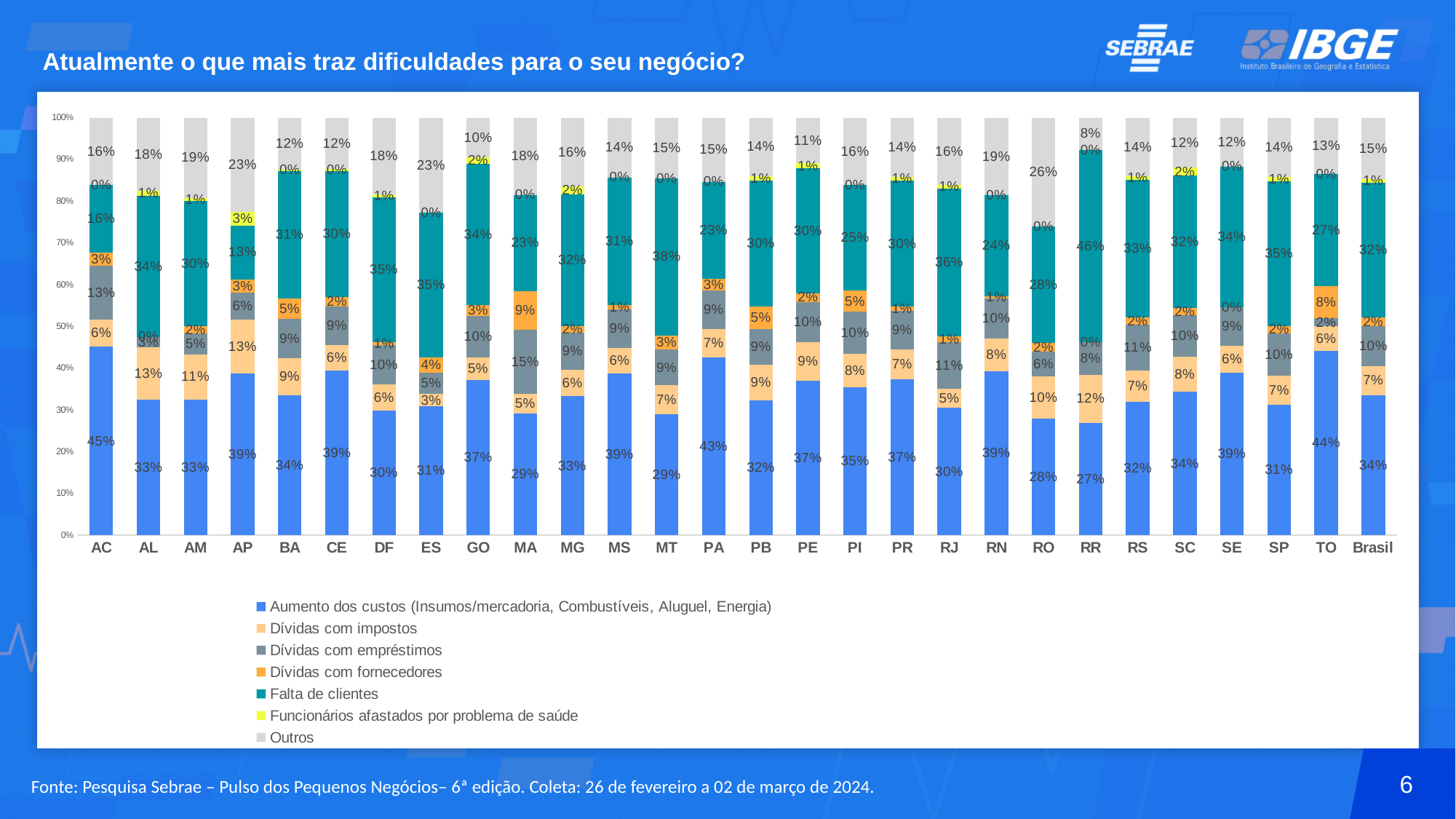
Which category has the highest value for 'Outros'? RO What kind of chart is shown on the slide? stacked bar chart How many series does the legend list? 7 What is the difference between 'Aumento dos custos' for AC and for Brasil? 11% Which category has the highest value for 'Aumento dos custos'? AC What is the value of 'Dívidas com empréstimos' for TO? 2% What is the value of 'Falta de clientes' for RR? 46% Which category has the lowest value for 'Aumento dos custos'? RR What is the title of the chart? Atualmente o que mais traz dificuldades para o seu negócio? What is the value of 'Aumento dos custos' for Brasil? 34% How many categories are shown on the x axis? 28 Which is larger for MA: 'Dívidas com fornecedores' or 'Dívidas com impostos'? Dívidas com fornecedores